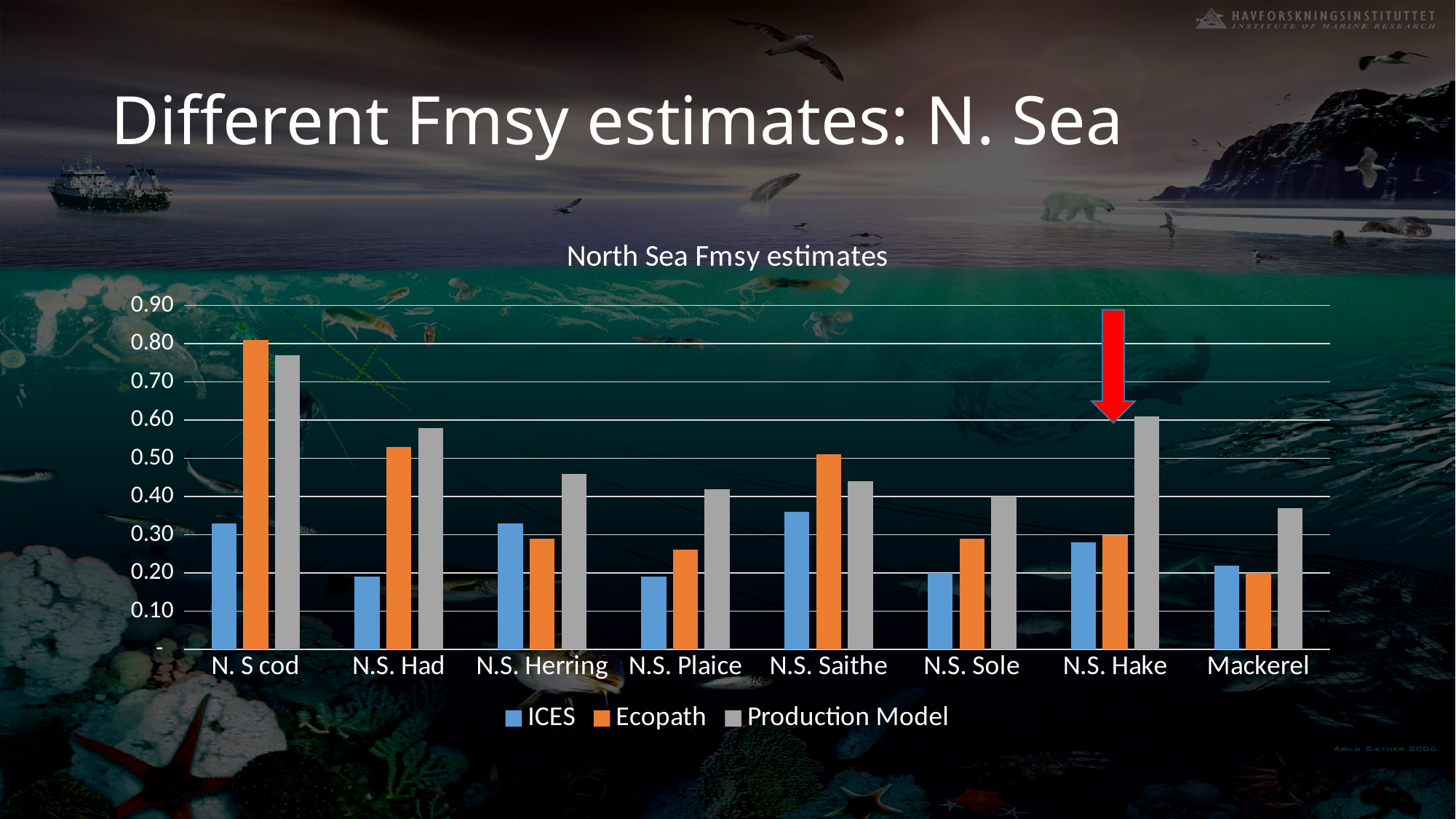
What is the title of the chart? North Sea Fmsy estimates For Mackerel, which is larger: the ICES value or the Production Model value? Production Model Is the Production Model value for N.S. Herring greater or less than 0.40? greater Is the Ecopath value for N. S cod greater or less than 0.70? greater Which category and series has the highest bar in the chart? N. S cod, Ecopath Is the Production Model value for N.S. Hake greater or less than 0.50? greater How many series does the legend list? 3 Which category has the highest Production Model value? N. S cod What kind of chart is shown on the slide? bar chart How many fish stock categories are shown on the x axis? 8 For N.S. Saithe, which is larger: the Ecopath value or the Production Model value? Ecopath